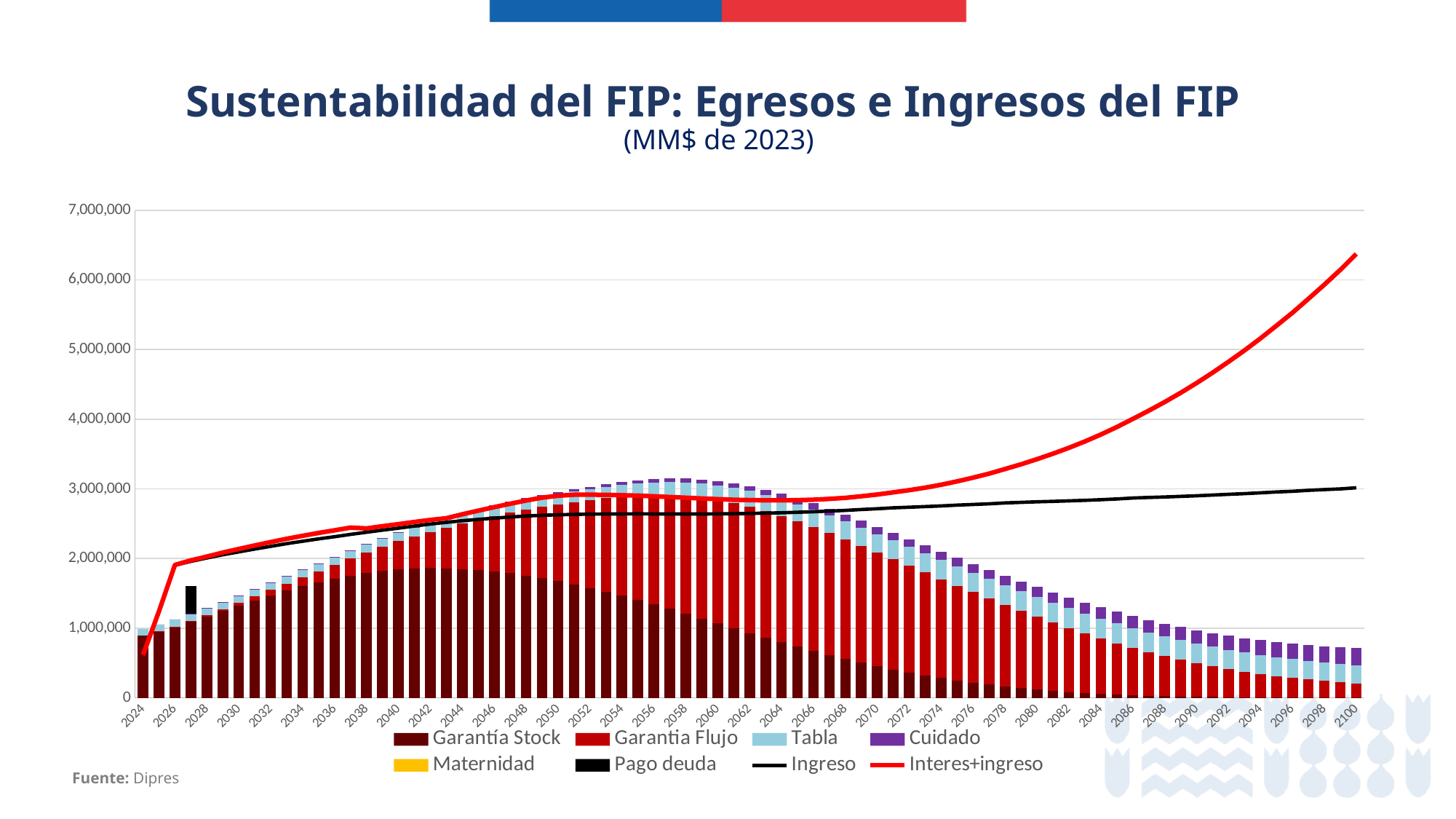
What is the title of the chart on the slide? Sustentabilidad del FIP: Egresos e Ingresos del FIP How many series does the legend list? 8 What kind of chart is shown on the slide? Combined stacked bar and line chart Is the value of the Interes+ingreso line in 2100 greater or less than 6,000,000? greater Is the value of the Interes+ingreso line in 2024 greater or less than 1,000,000? less Is the total height of the stacked bar in 2100 greater or less than 1,000,000? less Do the stacked bars rise or fall from 2060 to 2100? fall In which year does the Interes+ingreso line reach its highest value? 2100 Does the Interes+ingreso line rise or fall from 2024 to 2100? rise What unit is stated in the chart subtitle? MM$ de 2023 In 2100, which is larger: the Ingreso line or the Interes+ingreso line? Interes+ingreso